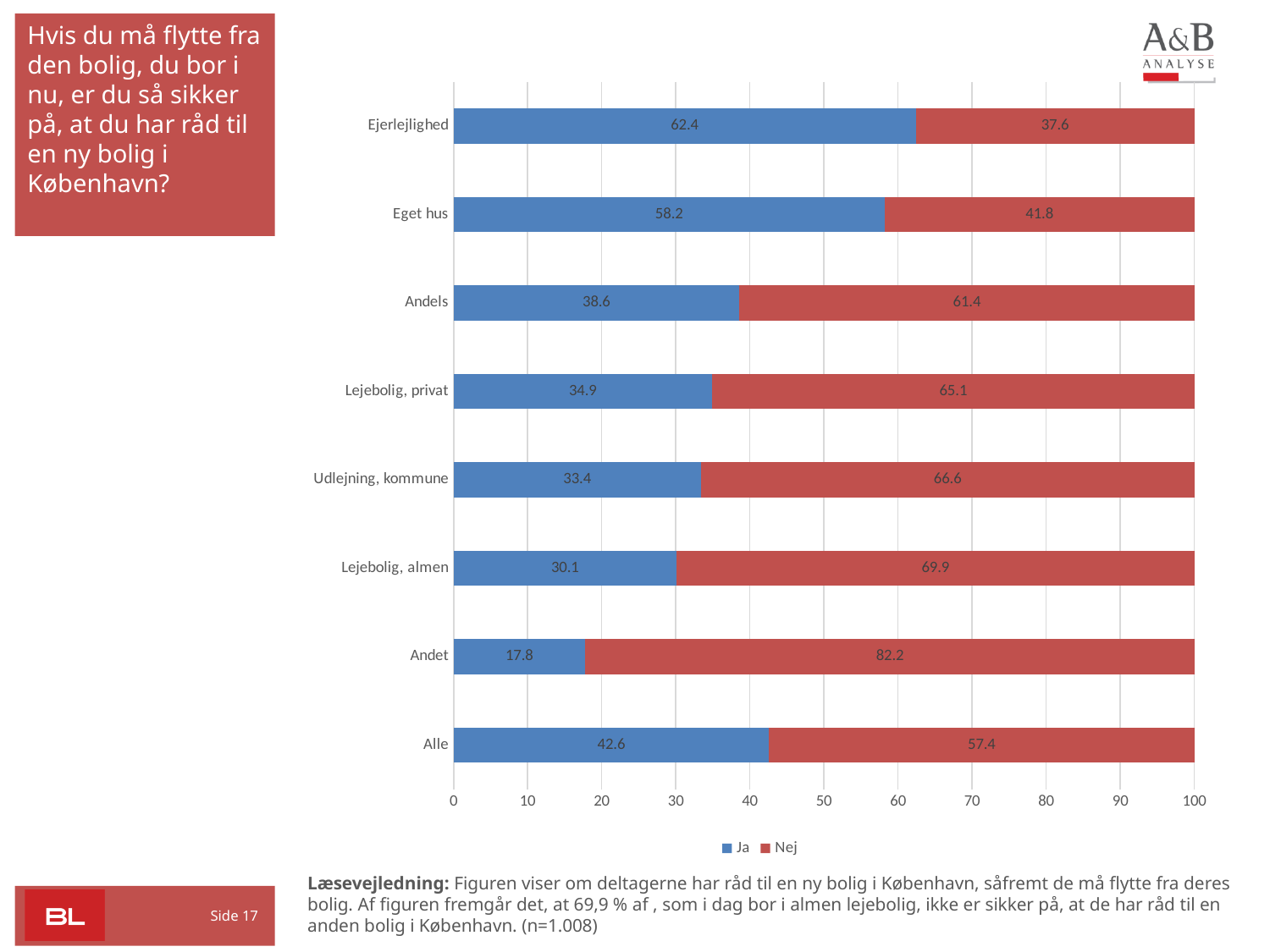
What is the difference between the "Nej" values for Andet and Ejerlejlighed? 44.6 Which colour represents the "Nej" series? Red Which is larger, the "Ja" value for Eget hus or the "Ja" value for Andels? Eget hus What is the total of the stacked bar for Udlejning, kommune? 100 What is the "Nej" value for Lejebolig, almen? 69.9 What is the "Ja" value for Alle? 42.6 Which category has the highest "Ja" value? Ejerlejlighed How many series does the legend list? 2 How many categories are shown on the y axis? 8 What kind of chart is shown? Stacked bar chart What is the "Ja" value for Ejerlejlighed? 62.4 Which category has the lowest "Ja" value? Andet